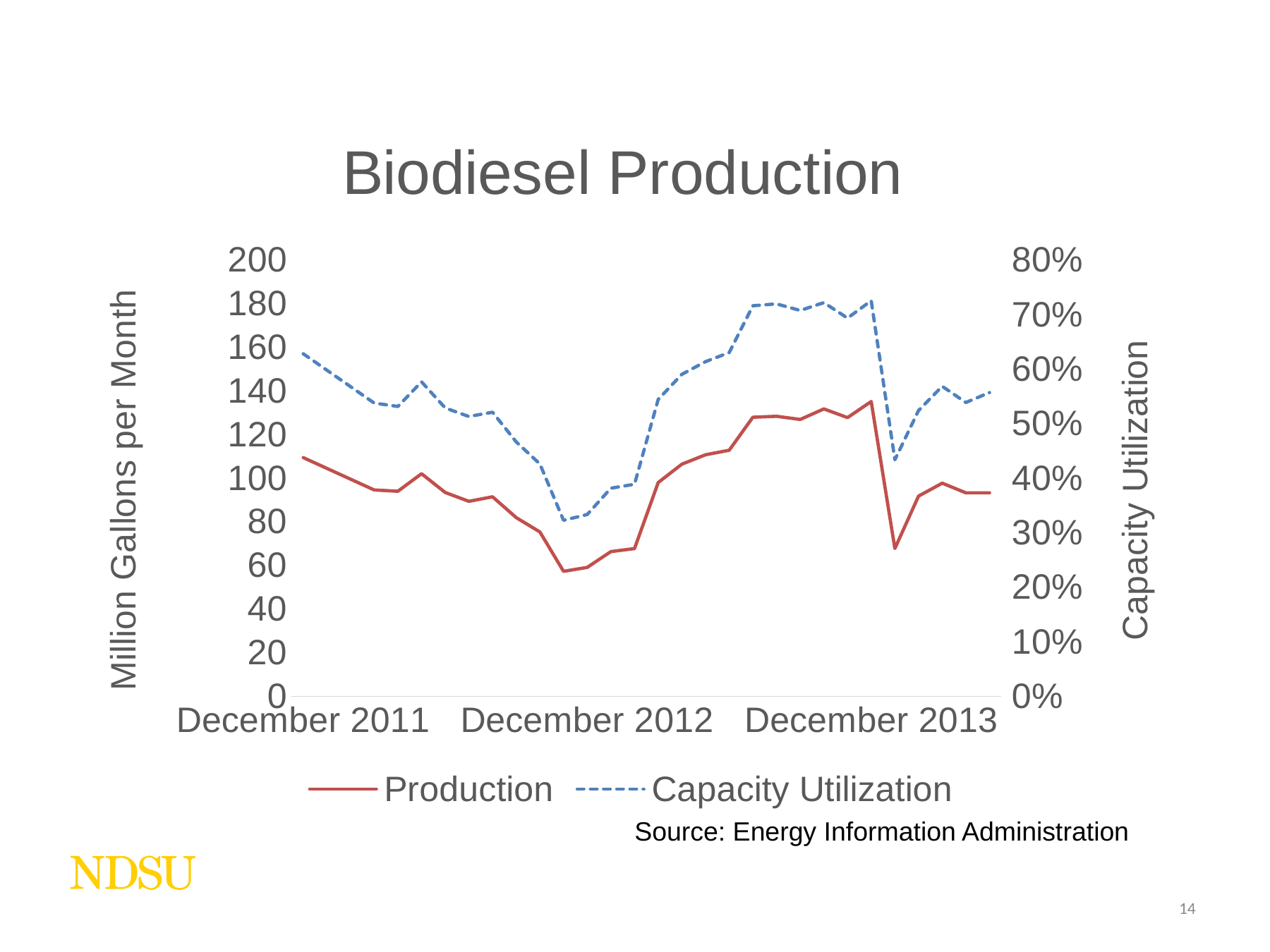
Is the Capacity Utilization value at December 2011 greater or less than 60%? greater Does Capacity Utilization rise or fall between December 2012 and December 2013? rise Which series is drawn with a dashed line? Capacity Utilization How many series does the legend list? 2 Is the Production value at December 2011 greater or less than 100? greater Is the Production value at December 2013 greater or less than 120? greater Does Production rise or fall between December 2011 and December 2012? fall What kind of chart is shown on the slide? line chart Is Production higher at December 2013 or at December 2012? December 2013 What is the title of the chart? Biodiesel Production